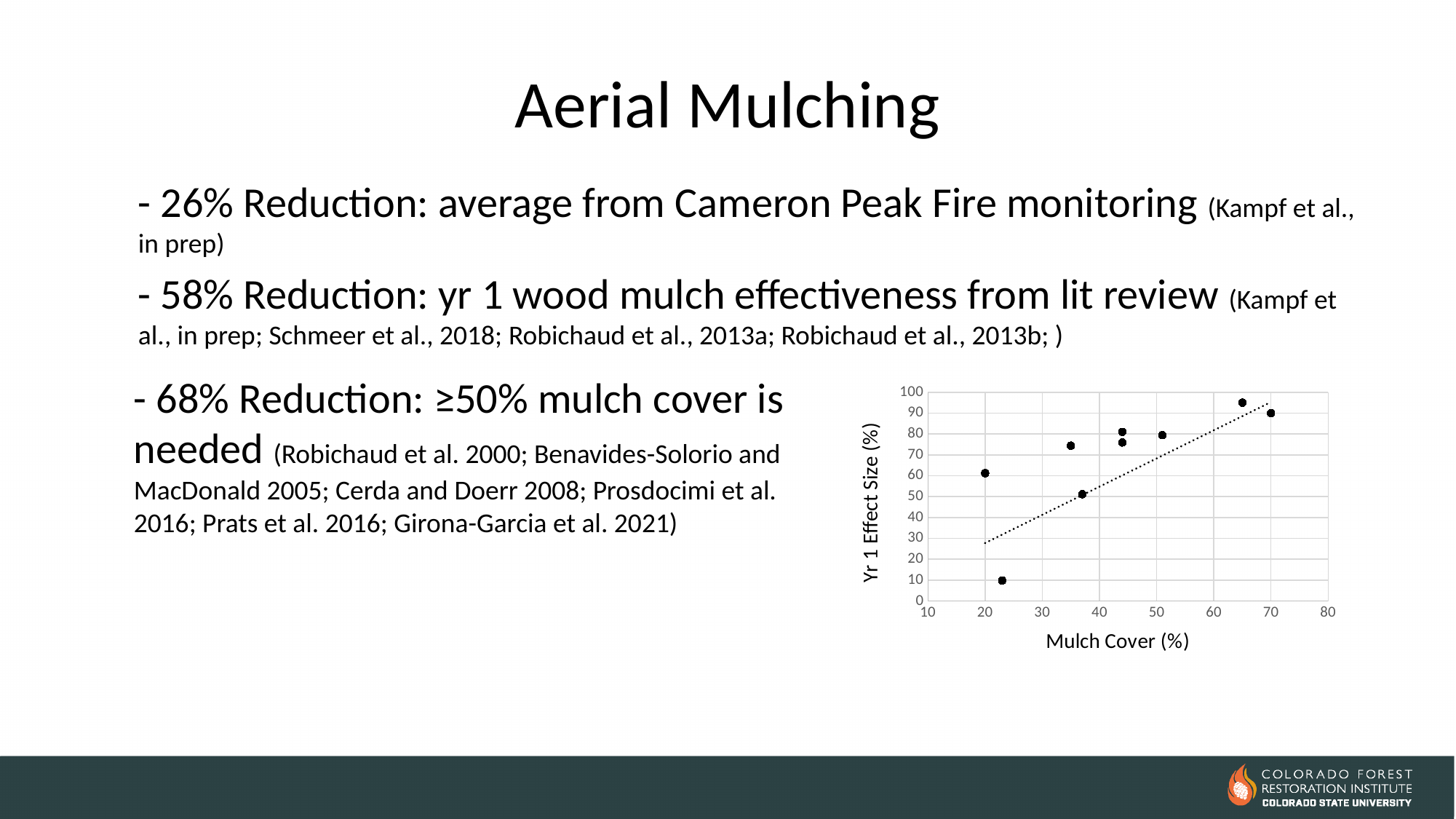
What is the label of the x axis of the chart? Mulch Cover (%) Is the Yr 1 Effect Size for the point at about 20% mulch cover greater or less than 50? greater Is the Yr 1 Effect Size for the point at about 65% mulch cover greater or less than 90? greater What is the maximum value shown on the y axis of the chart? 100 Which point has the highest Yr 1 Effect Size: the one at about 65% mulch cover or the one at about 70% mulch cover? the one at about 65% mulch cover Does the Yr 1 Effect Size generally rise or fall as Mulch Cover increases? rise Is the Yr 1 Effect Size for the point at about 23% mulch cover greater or less than 20? less What is the label of the y axis of the chart? Yr 1 Effect Size (%) How many data points are plotted in the scatter chart? 9 Which point has the lowest Yr 1 Effect Size: the one at about 20% mulch cover or the one at about 23% mulch cover? the one at about 23% mulch cover What kind of chart is shown on the slide? scatter plot